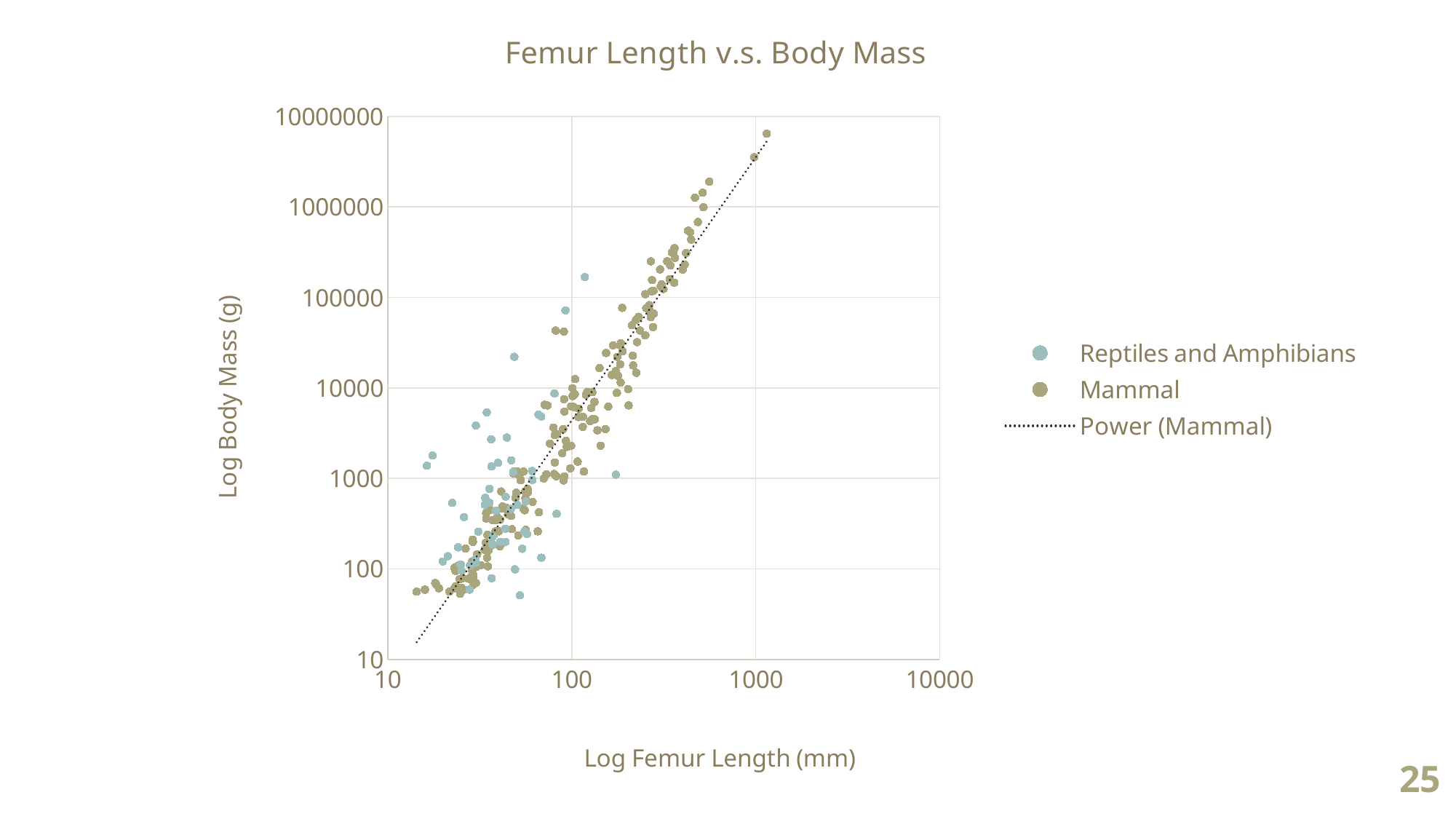
What is the label of the vertical axis? Log Body Mass (g) What kind of chart is shown on the slide? Scatter chart Which series does the dotted trendline belong to? Mammal As femur length increases along the x axis, does body mass generally rise or fall? Rise Is the highest Reptiles and Amphibians point greater or less than 1000000 in body mass? less Is the body mass of the highest Mammal point greater or less than 1000000? greater What is the title of the chart? Femur Length v.s. Body Mass How many entries does the chart legend list? 3 Is the body mass of the lowest plotted point greater or less than 100? less Which series has points extending to the largest femur lengths? Mammal Which series reaches the highest body mass on the chart, Reptiles and Amphibians or Mammal? Mammal